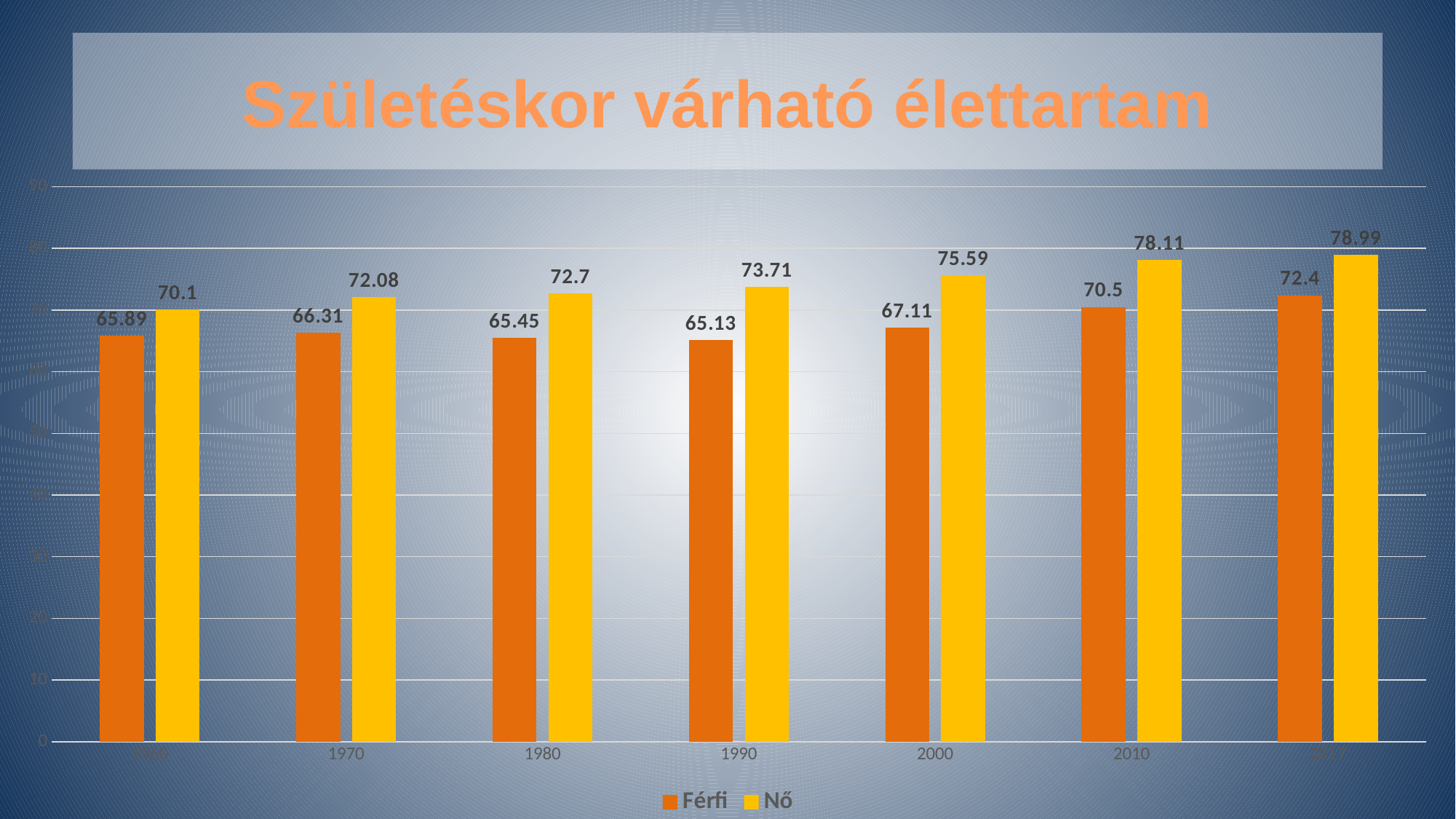
What is the value for Nő in 2000? 75.59 How many years (categories) are shown on the x axis? 7 Is the value for Nő in 2010 greater or less than 70? greater What is the difference between the Nő and Férfi values in 2000? 8.48 What is the value for Férfi in 2010? 70.5 What is the value for Férfi in 1980? 65.45 Which is larger, the Férfi value in 1970 or in 1980? 1970 How many series does the legend list? 2 In which year is the Férfi value lowest? 1990 What is the value for Nő in 1990? 73.71 What is the highest value shown in the Nő series? 78.99 What kind of chart is shown on the slide? bar chart